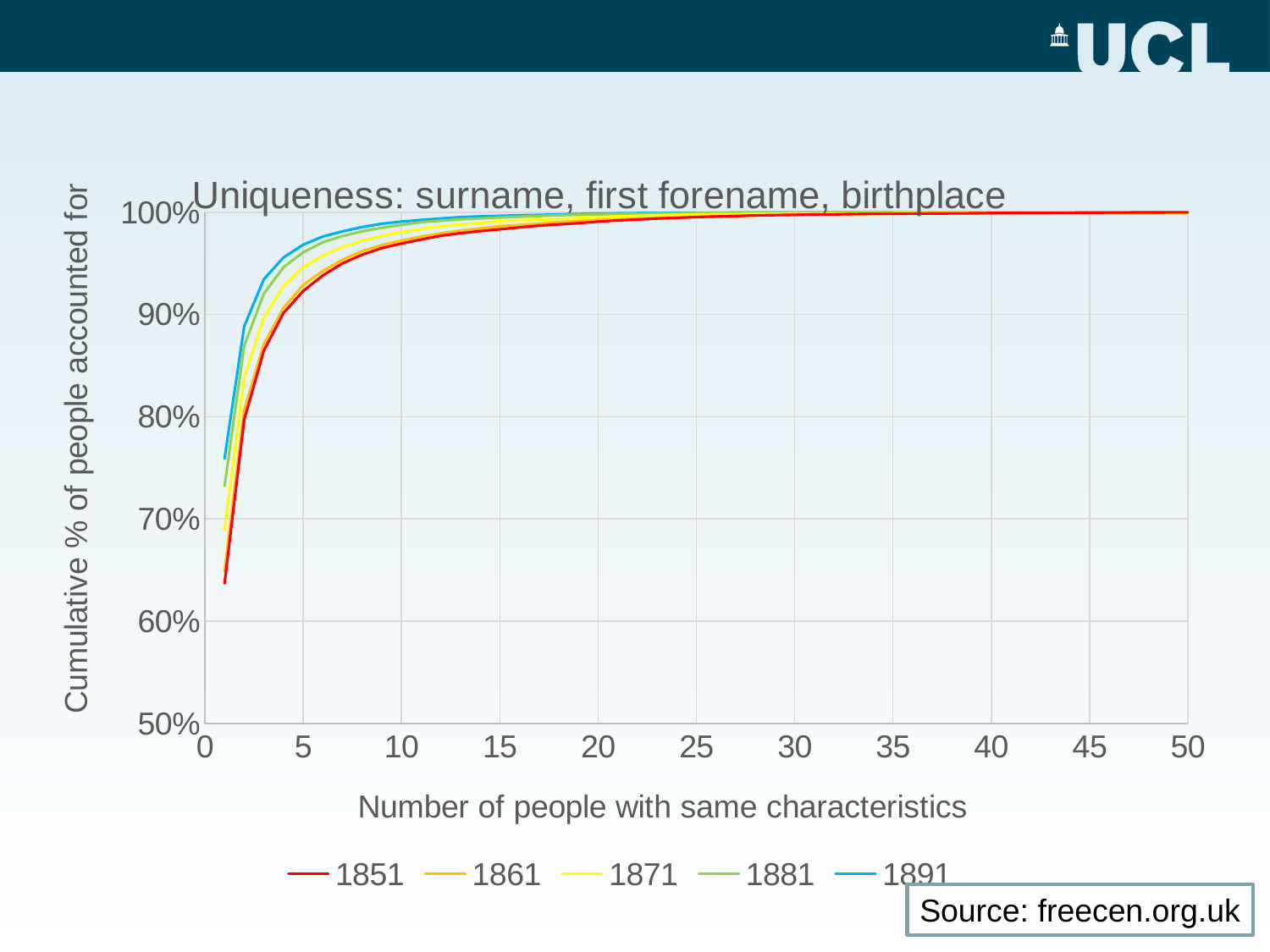
What is the title of the chart? Uniqueness: surname, first forename, birthplace How many series does the legend list? 5 At 1 person with the same characteristics, is the value for 1891 greater or less than 70%? greater What kind of chart is shown on the slide? line chart What is the label of the x axis? Number of people with same characteristics Do the values for the 1851 series rise or fall as the number of people with same characteristics increases? rise At 1 person with the same characteristics, is the value for 1871 greater or less than 80%? less At 1 person with the same characteristics, is the value for 1851 greater or less than 70%? less Which series has the highest cumulative percentage at 1 person with the same characteristics? 1891 At 1 person with the same characteristics, which is larger: the value for 1891 or the value for 1851? 1891 Which series has the lowest cumulative percentage at 1 person with the same characteristics? 1851